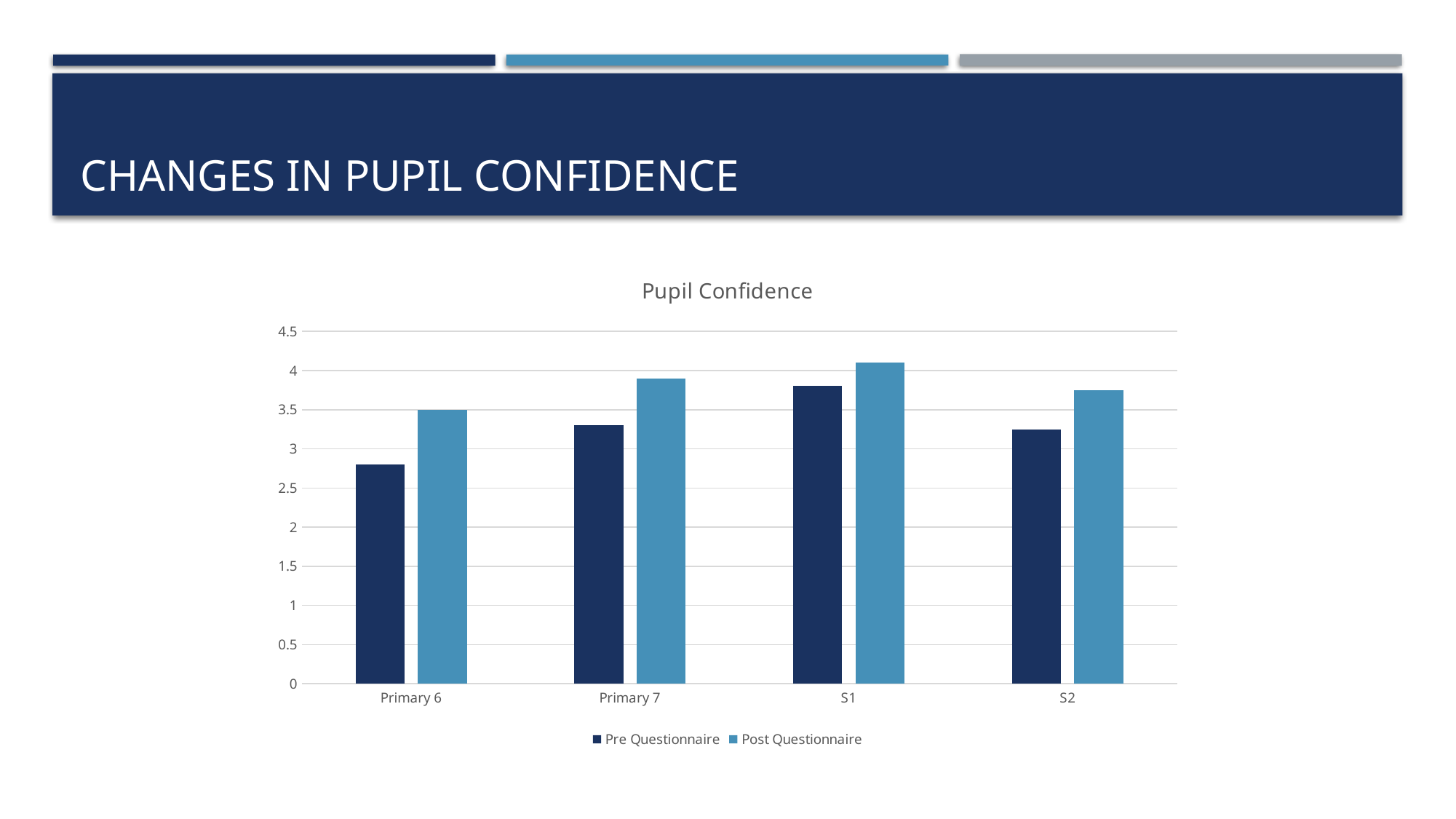
Which year group has the lowest Pre Questionnaire value? Primary 6 What kind of chart is shown on the slide? Bar chart How many year groups are shown on the x axis? 4 Is the Post Questionnaire value for Primary 7 greater or less than 3.5? greater Which is larger, the Pre Questionnaire value for S1 or the Pre Questionnaire value for Primary 7? S1 In every year group, is the Post Questionnaire bar higher or lower than the Pre Questionnaire bar? Higher Is the Post Questionnaire value for S1 greater or less than 4? greater How many series does the legend list? 2 Is the Pre Questionnaire value for Primary 6 greater or less than 3? less What is the title of the chart? Pupil Confidence Which year group has the highest Post Questionnaire value? S1